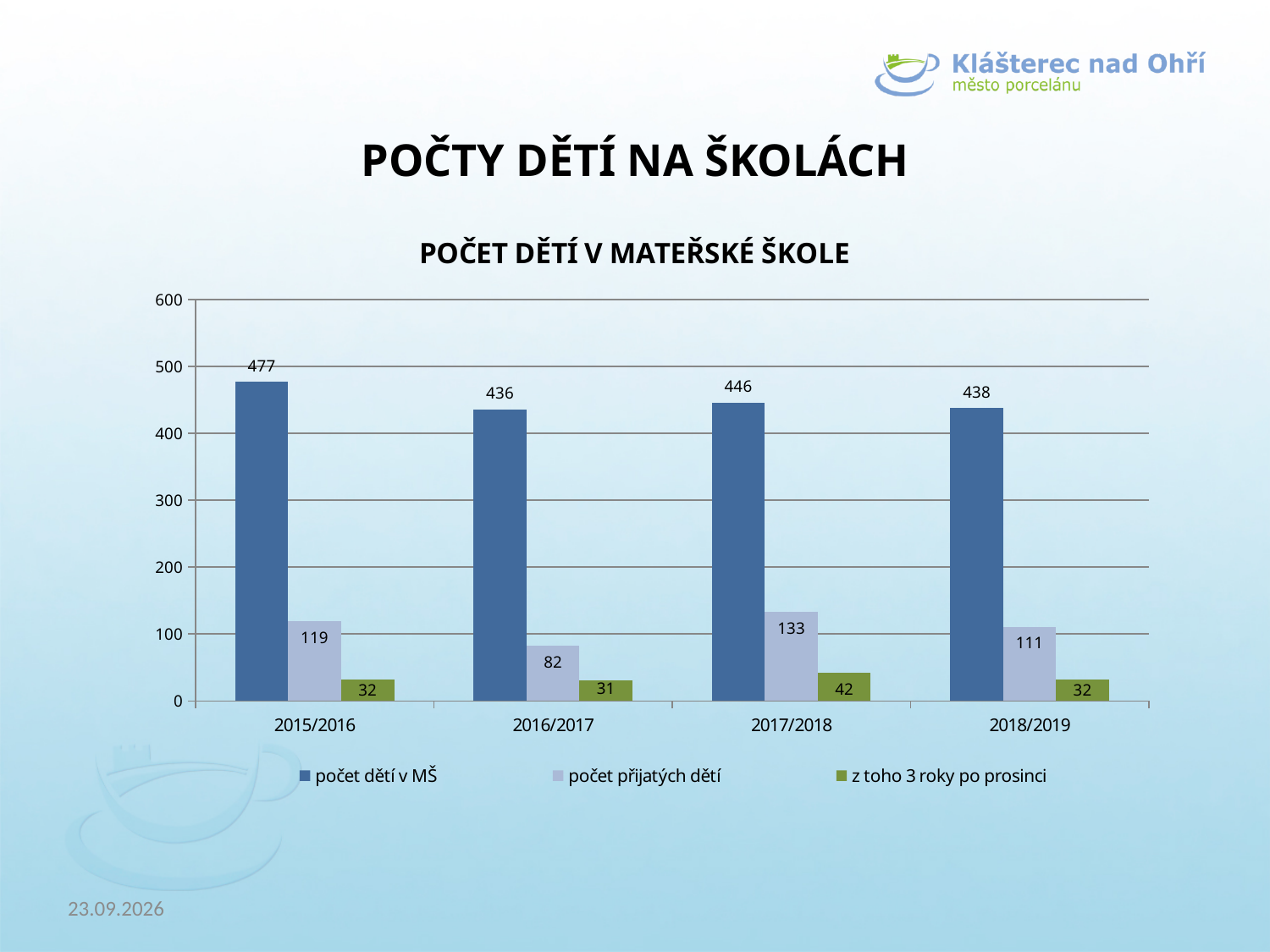
Which school year has the lowest value for 'počet přijatých dětí'? 2016/2017 Which school year has the highest value for 'počet dětí v MŠ'? 2015/2016 Which is larger: 'počet přijatých dětí' in 2015/2016 or in 2018/2019? 2015/2016 What is the difference between 'počet dětí v MŠ' in 2015/2016 and 2016/2017? 41 How many series does the legend list? 3 Is the value of 'počet dětí v MŠ' for 2017/2018 greater or less than 400? greater What kind of chart is shown on the slide? bar chart What is the title of the chart? POČET DĚTÍ V MATEŘSKÉ ŠKOLE What is the value of 'počet dětí v MŠ' for 2015/2016? 477 What is the value of 'počet přijatých dětí' for 2017/2018? 133 How many school years are shown on the x axis? 4 What is the value of 'z toho 3 roky po prosinci' for 2016/2017? 31